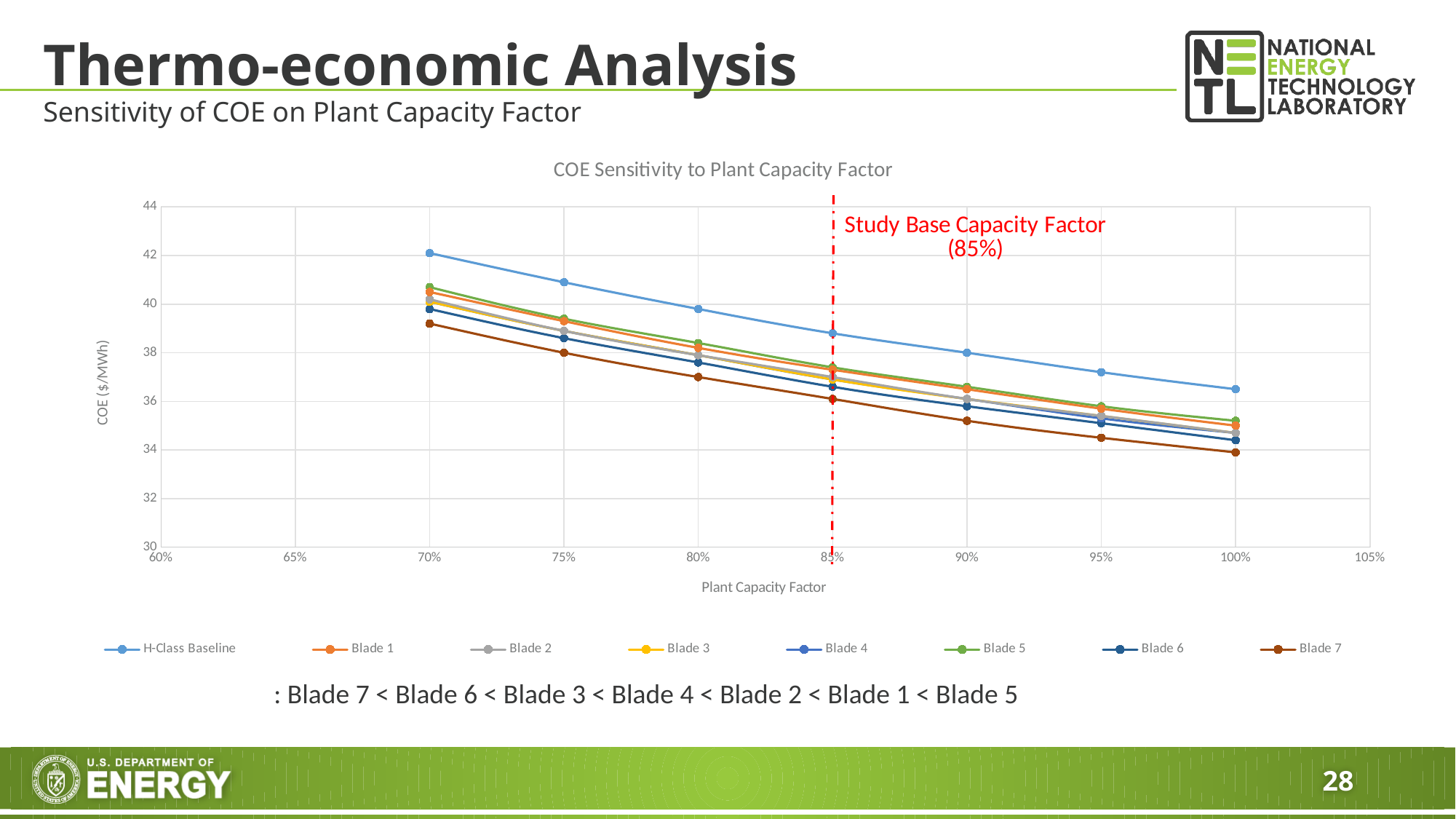
Is the COE for Blade 7 at a 70% plant capacity factor greater or less than 40? less Is the COE for H-Class Baseline at a 70% plant capacity factor greater or less than 40? greater At a 70% plant capacity factor, which is larger: the COE for H-Class Baseline or for Blade 7? H-Class Baseline Is the COE for Blade 7 at a 100% plant capacity factor greater or less than 36? less How many plant capacity factor points are plotted for each series? 7 What kind of chart is shown on the slide? Line chart How many series does the legend list? 8 Which series has the highest COE at a 70% plant capacity factor? H-Class Baseline Do the COE values rise or fall as the plant capacity factor increases? Fall What is the title of the chart? COE Sensitivity to Plant Capacity Factor What capacity factor does the red dashed vertical line mark as the study base? 85% Which series has the lowest COE at a 100% plant capacity factor? Blade 7